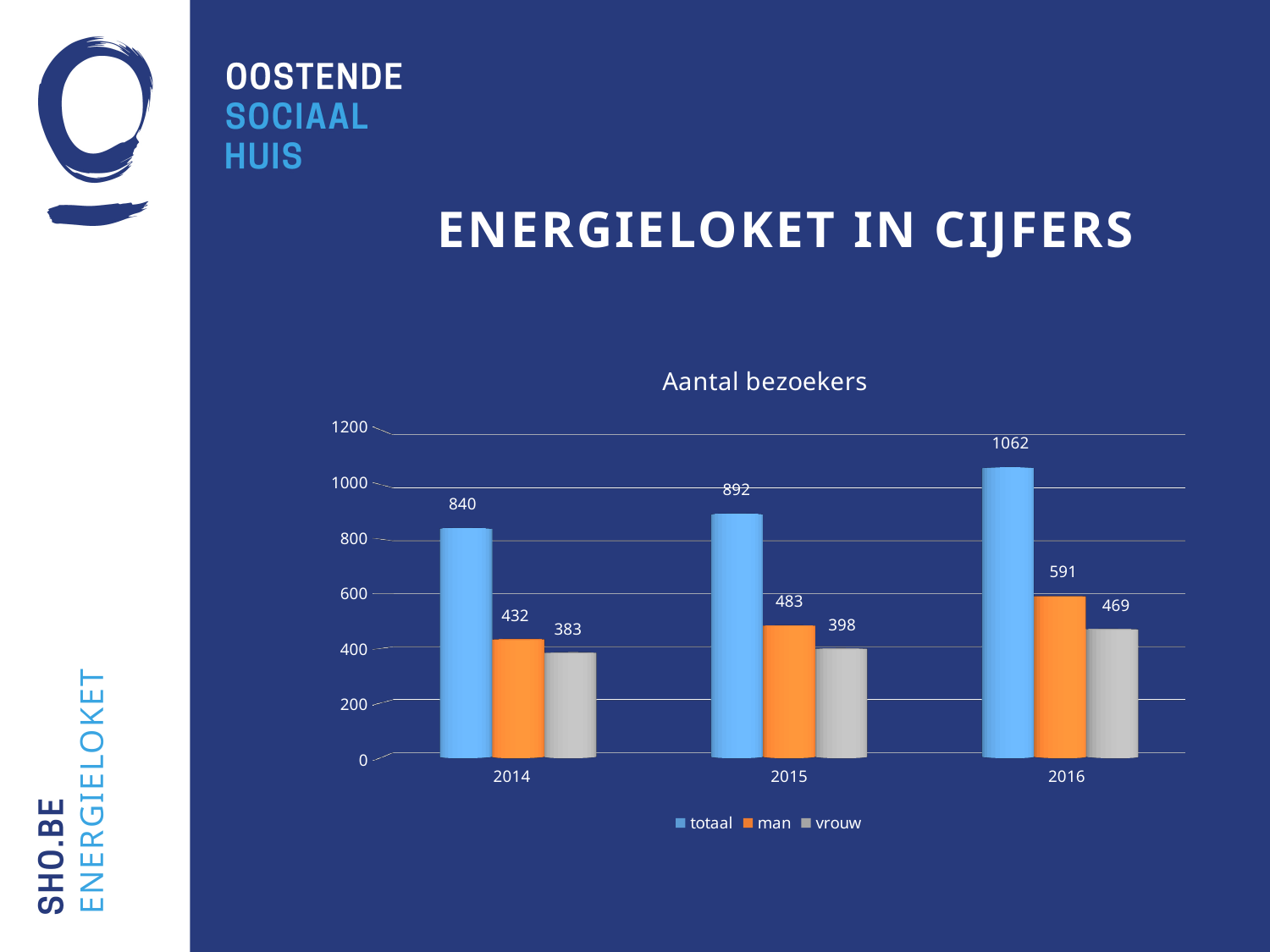
What is the value for man in 2014? 432 What is the value for vrouw in 2015? 398 Which year has the lowest value for vrouw? 2014 How many series does the legend list? 3 What is the difference between the man and vrouw values in 2016? 122 What is the difference between the totaal values for 2015 and 2014? 52 What kind of chart is shown on the slide? bar chart What is the value for totaal in 2016? 1062 Is the value for totaal in 2015 greater or less than 800? greater Which year has the highest value for totaal? 2016 Which is larger in 2015: the value for man or the value for vrouw? man How many years are shown on the x axis? 3